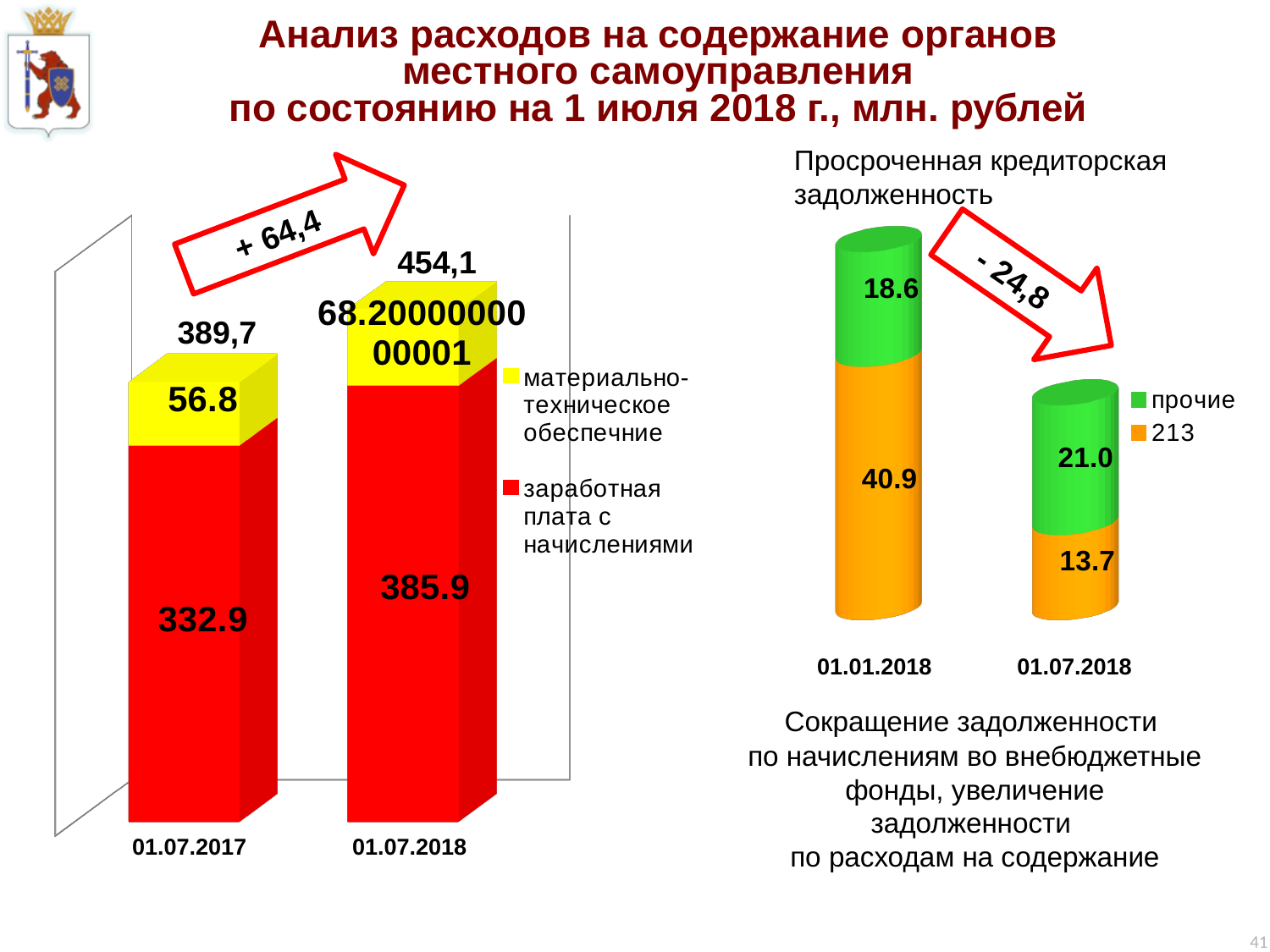
In the left chart, what is the value for 'заработная плата с начислениями' on 01.07.2018? 385.9 In the chart 'Просроченная кредиторская задолженность', which is larger on 01.01.2018: 'прочие' or '213'? 213 In the left chart, what is the total shown above the bar for 01.07.2017? 389,7 In the left chart, what is the value for 'заработная плата с начислениями' on 01.07.2017? 332.9 In the chart 'Просроченная кредиторская задолженность', what is the total of the stacked bar for 01.07.2018? 34.7 In the chart 'Просроченная кредиторская задолженность', what is the value for 'прочие' on 01.07.2018? 21.0 In the left chart, what is the total shown above the bar for 01.07.2018? 454,1 In the left chart, what is the value for 'материально-техническое обеспечние' on 01.07.2017? 56.8 In the left chart, how many series does the legend list? 2 In the chart 'Просроченная кредиторская задолженность', what is the value for '213' on 01.01.2018? 40.9 In the left chart, by how much did 'заработная плата с начислениями' change from 01.07.2017 to 01.07.2018? 53.0 What kind of chart is the chart 'Просроченная кредиторская задолженность'? Stacked bar chart